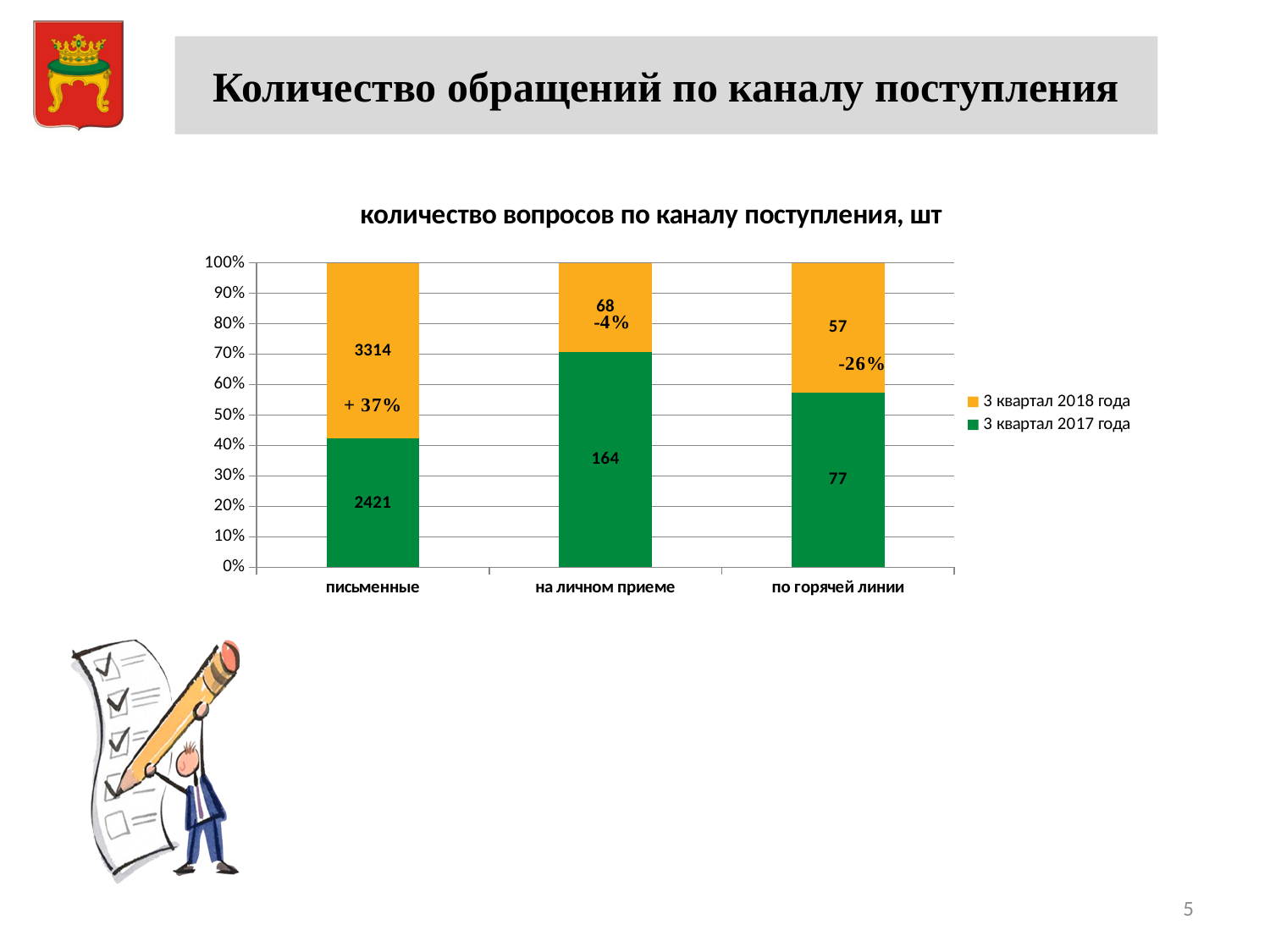
What is the difference between the 3 квартал 2018 года and 3 квартал 2017 года values for письменные? 893 How many categories are shown on the x axis? 3 What is the value for письменные in the 3 квартал 2018 года series? 3314 How many series does the legend list? 2 Which is larger for на личном приеме: the 3 квартал 2017 года value or the 3 квартал 2018 года value? 3 квартал 2017 года What is the value for письменные in the 3 квартал 2017 года series? 2421 What percentage change is labelled on the bar for по горячей линии? -26% What is the value for по горячей линии in the 3 квартал 2018 года series? 57 Which category has the highest value in the 3 квартал 2018 года series? письменные Which category has the lowest value in the 3 квартал 2017 года series? по горячей линии What kind of chart is shown on the slide? stacked bar chart What is the value for на личном приеме in the 3 квартал 2017 года series? 164